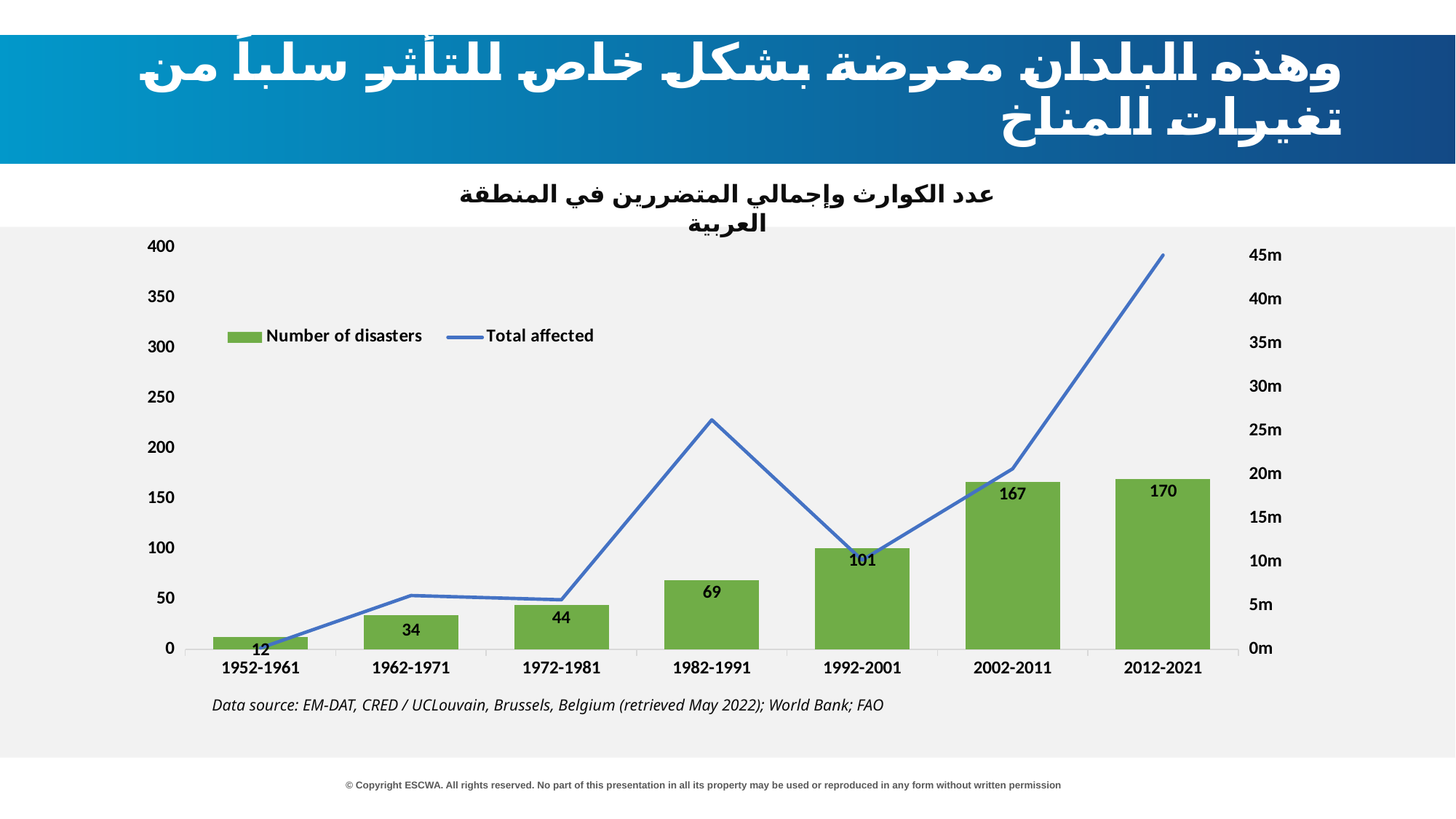
What is the number of disasters for 1982-1991? 69 What is the number of disasters for 1952-1961? 12 Which period has the lowest number of disasters? 1952-1961 What is the number of disasters for 2012-2021? 170 Is the total affected for 2012-2021 greater or less than 40m? greater Is the total affected for 1982-1991 greater or less than 20m? greater Which period has more disasters, 1962-1971 or 1972-1981? 1972-1981 How many series does the legend list? 2 Is the total affected for 1992-2001 greater or less than 15m? less What is the difference in the number of disasters between 2002-2011 and 1992-2001? 66 Which period has the highest number of disasters? 2012-2021 How many time periods are shown on the x axis? 7